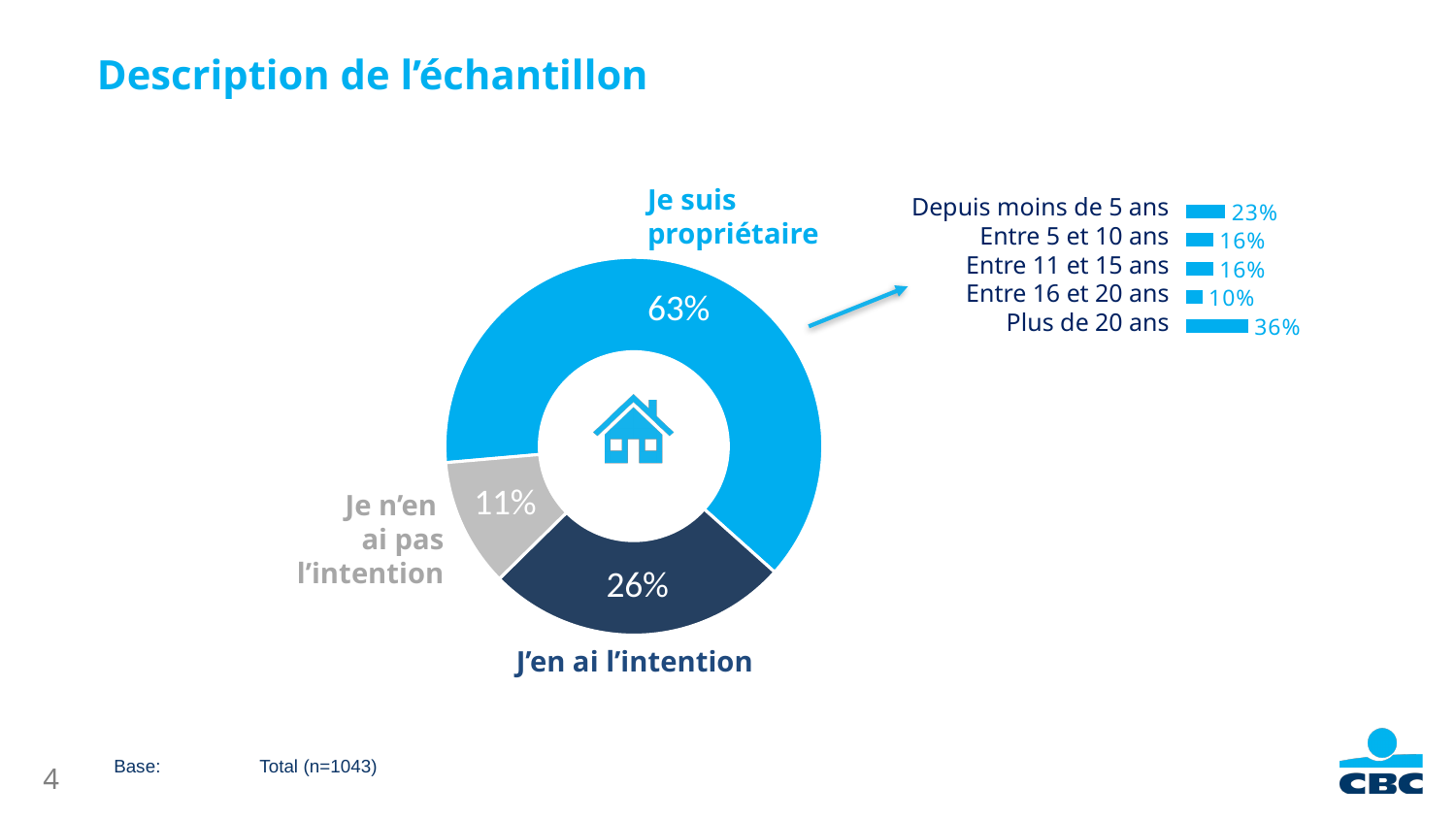
In the donut chart on the left, how many slices are there? 3 In the bar chart on the right, which is larger: "Depuis moins de 5 ans" or "Entre 5 et 10 ans"? Depuis moins de 5 ans In the donut chart on the left, which category has the smallest share? Je n'en ai pas l'intention In the donut chart on the left, what share of respondents answered "Je suis propriétaire"? 63% In the donut chart on the left, what is the difference in percentage points between "Je suis propriétaire" and "J'en ai l'intention"? 37 In the bar chart on the right, how many categories are shown? 5 In the bar chart on the right, what is the value for "Plus de 20 ans"? 36% In the bar chart on the right, what is the value for "Depuis moins de 5 ans"? 23% In the bar chart on the right, which category has the lowest value? Entre 16 et 20 ans In the donut chart on the left, what share of respondents answered "Je n'en ai pas l'intention"? 11% In the donut chart on the left, what share of respondents answered "J'en ai l'intention"? 26% In the donut chart on the left, which category has the largest share? Je suis propriétaire